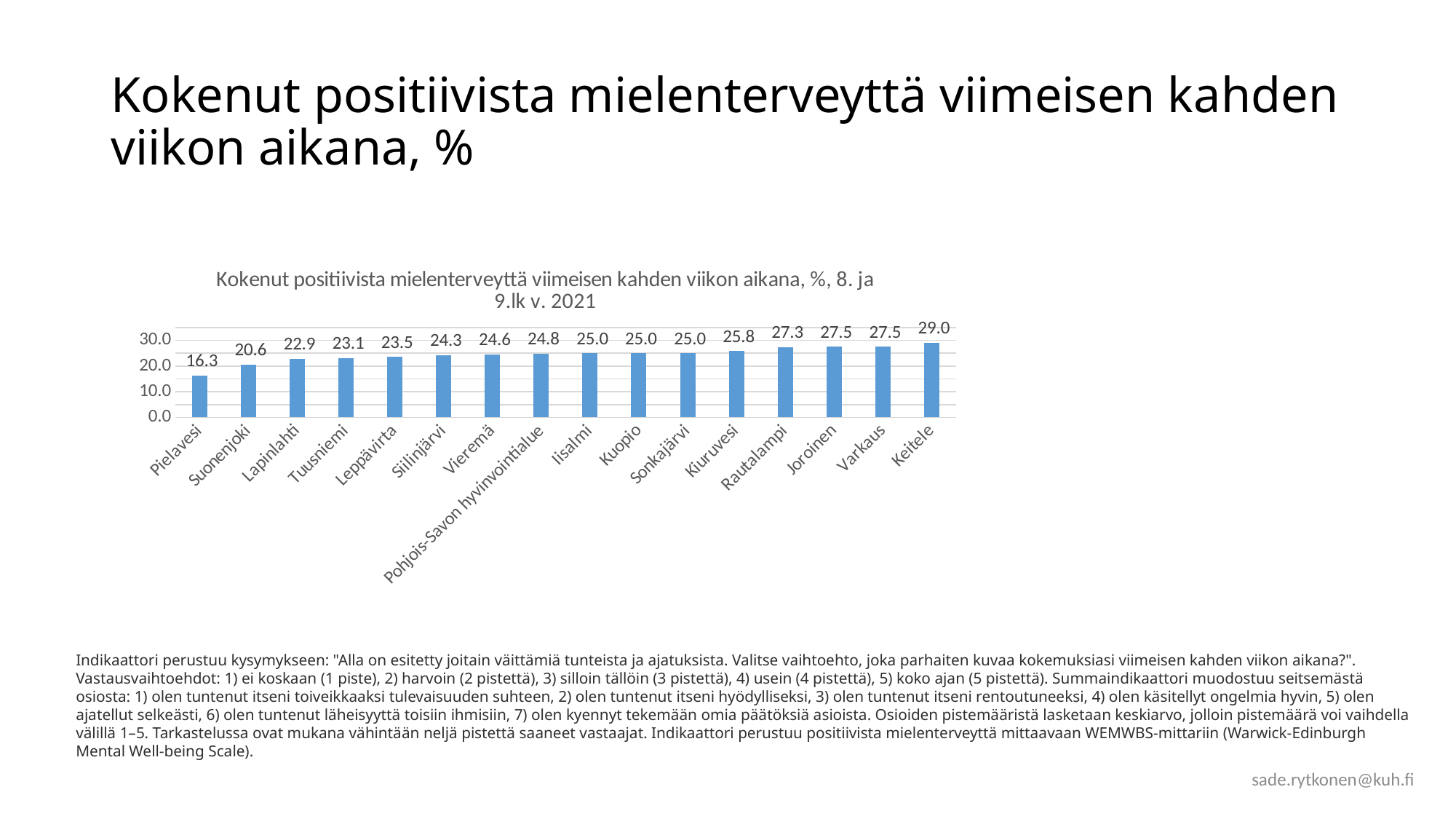
What kind of chart is shown on the slide? bar chart Which category has the lowest value? Pielavesi Is the value for Pielavesi greater or less than 20.0? less Which category has the highest value? Keitele What is the value for Pohjois-Savon hyvinvointialue? 24.8 Do the values rise or fall from left to right along the x axis? rise How many categories are shown on the x axis? 16 What is the difference between the values for Keitele and Pielavesi? 12.7 What is the value for Siilinjärvi? 24.3 What is the value for Kuopio? 25.0 Which has a larger value, Suonenjoki or Kiuruvesi? Kiuruvesi What is the difference between the values for Rautalampi and Lapinlahti? 4.4